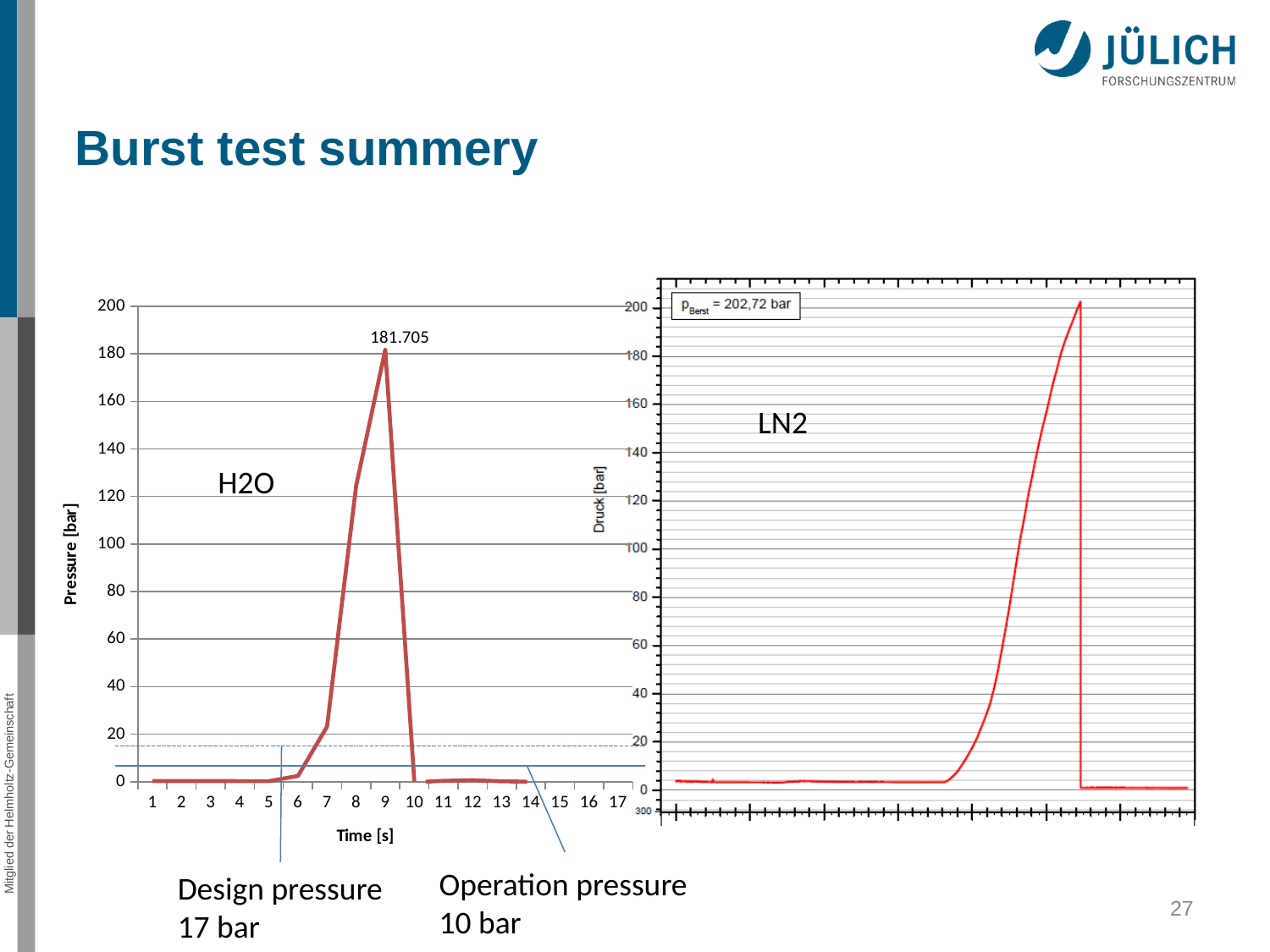
What is the y-axis label of the H2O chart on the left? Pressure [bar] On the H2O chart (left), is the pressure at time 8 s greater or less than 100? greater On the H2O chart (left), does the pressure rise or fall between 6 s and 9 s? rise On the H2O chart (left), how many time points are marked on the x axis? 17 On the H2O chart (left), what is the peak pressure value labelled on the curve? 181.705 What design pressure is annotated below the H2O chart? 17 bar What kind of chart is the H2O chart on the left? line chart On the LN2 chart (right), what burst pressure (p_Berst) is stated in the box? 202,72 bar On the H2O chart (left), at which time in seconds does the pressure reach its maximum? 9 On the H2O chart (left), is the pressure at time 10 s greater or less than 20? less What is the y-axis label of the LN2 chart on the right? Druck [bar] Which test reached the higher burst pressure, H2O or LN2? LN2